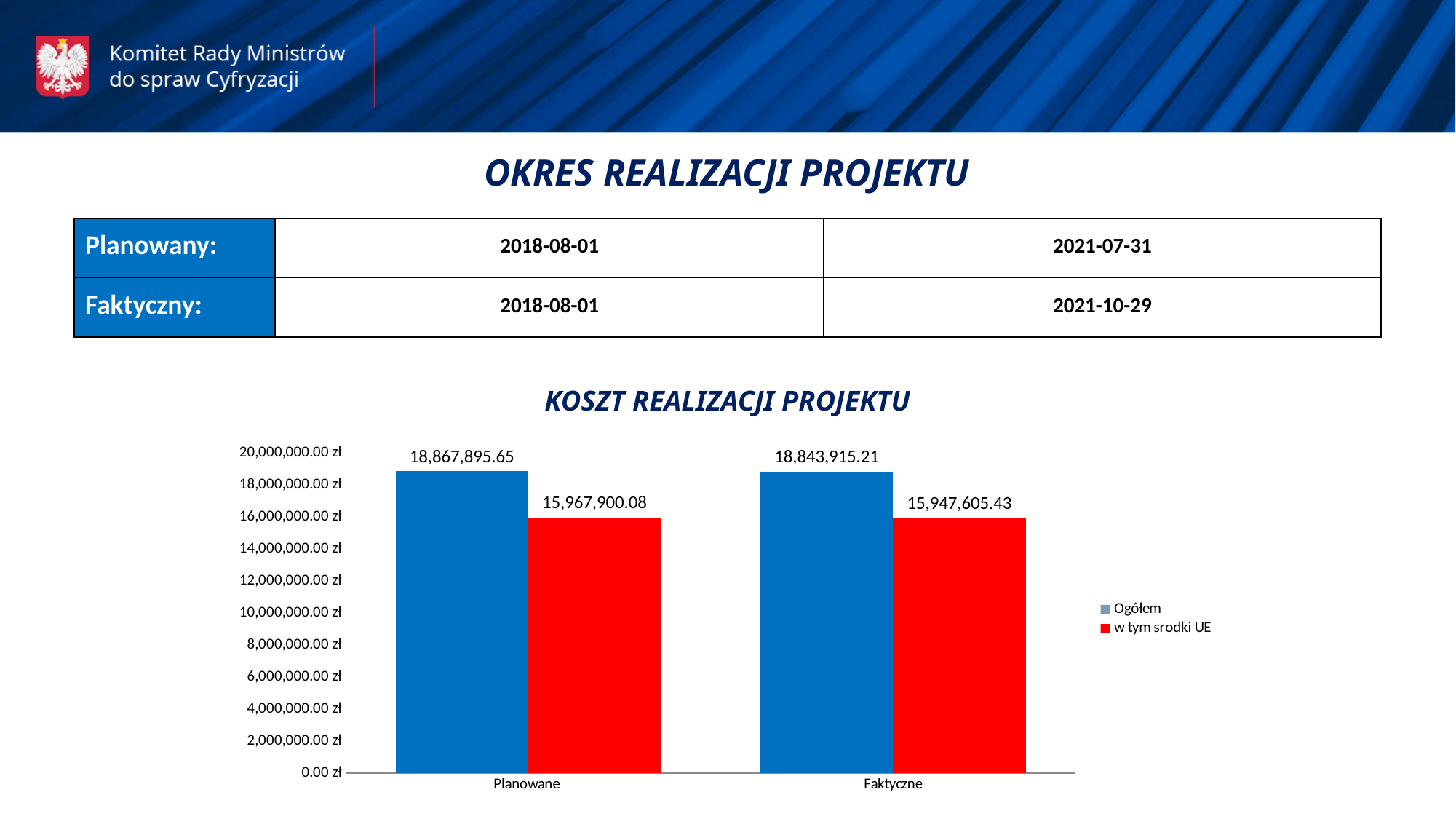
In the KOSZT REALIZACJI PROJEKTU chart, what is the Ogółem value for Planowane? 18,867,895.65 In the KOSZT REALIZACJI PROJEKTU chart, what is the difference between the Ogółem values for Planowane and Faktyczne? 23,980.44 In the KOSZT REALIZACJI PROJEKTU chart, is the Ogółem value for Faktyczne greater or less than 18,000,000.00 zł? greater In the KOSZT REALIZACJI PROJEKTU chart, what is the difference between the Ogółem and 'w tym srodki UE' values for Planowane? 2,899,995.57 What kind of chart is shown under the title KOSZT REALIZACJI PROJEKTU? bar chart In the KOSZT REALIZACJI PROJEKTU chart, what is the Ogółem value for Faktyczne? 18,843,915.21 How many series does the legend of the KOSZT REALIZACJI PROJEKTU chart list? 2 In the KOSZT REALIZACJI PROJEKTU chart, what is the 'w tym srodki UE' value for Planowane? 15,967,900.08 How many categories are shown on the x axis of the KOSZT REALIZACJI PROJEKTU chart? 2 In the KOSZT REALIZACJI PROJEKTU chart, what is the 'w tym srodki UE' value for Faktyczne? 15,947,605.43 In the KOSZT REALIZACJI PROJEKTU chart, which is larger: the Ogółem value for Planowane or for Faktyczne? Planowane In the KOSZT REALIZACJI PROJEKTU chart, what colour are the 'w tym srodki UE' bars? red